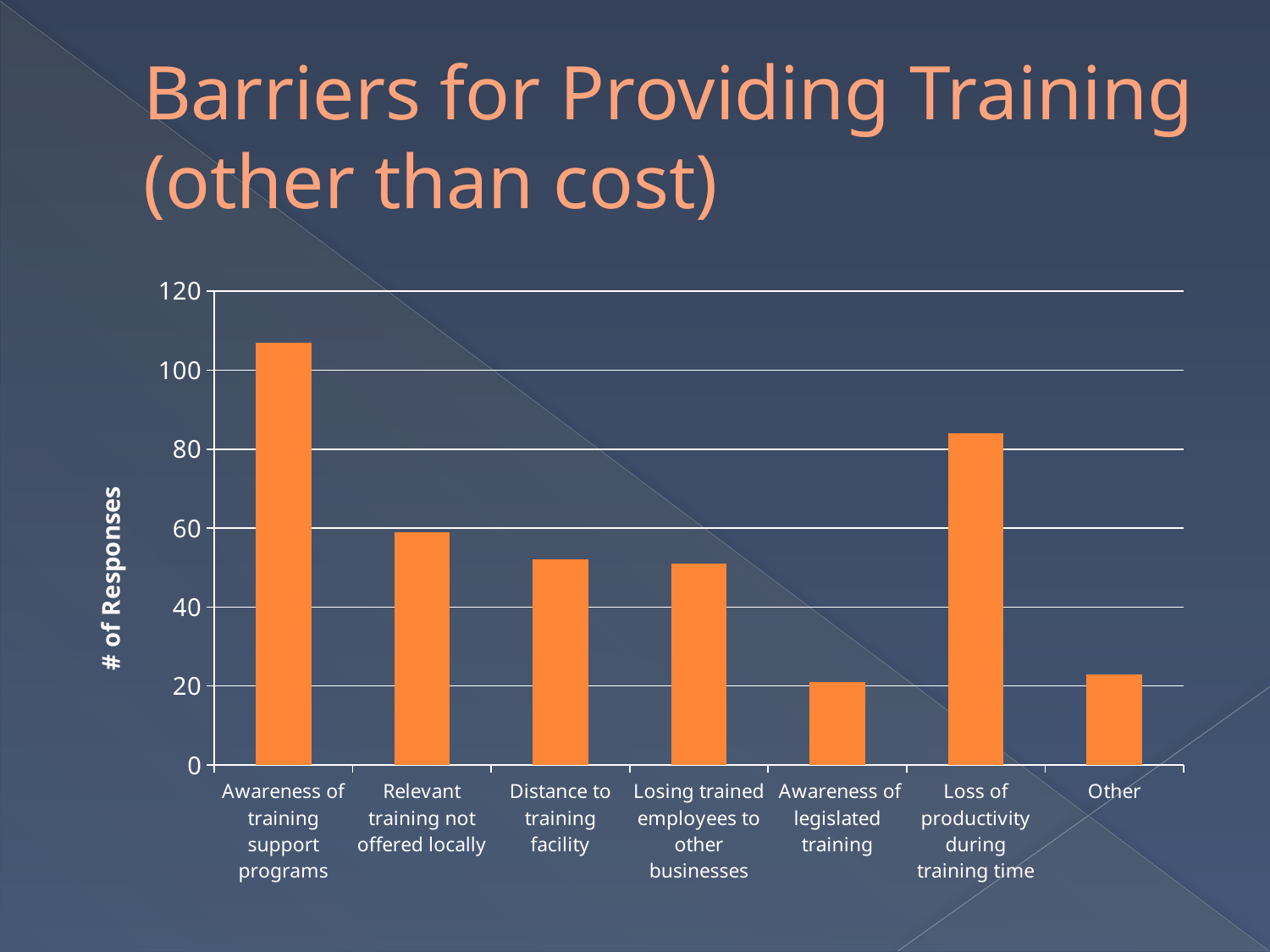
Is the value for Loss of productivity during training time greater or less than 80? greater Is the value for Awareness of training support programs greater or less than 100? greater Is the value for Other greater or less than 20? greater Which has more responses: Loss of productivity during training time or Relevant training not offered locally? Loss of productivity during training time Which barrier has the highest number of responses? Awareness of training support programs What is the title of the slide containing the chart? Barriers for Providing Training (other than cost) How many categories (bars) are shown in the chart? 7 Which has more responses: Distance to training facility or Awareness of legislated training? Distance to training facility What kind of chart is shown on the slide? bar chart What is the label on the vertical axis of the chart? # of Responses